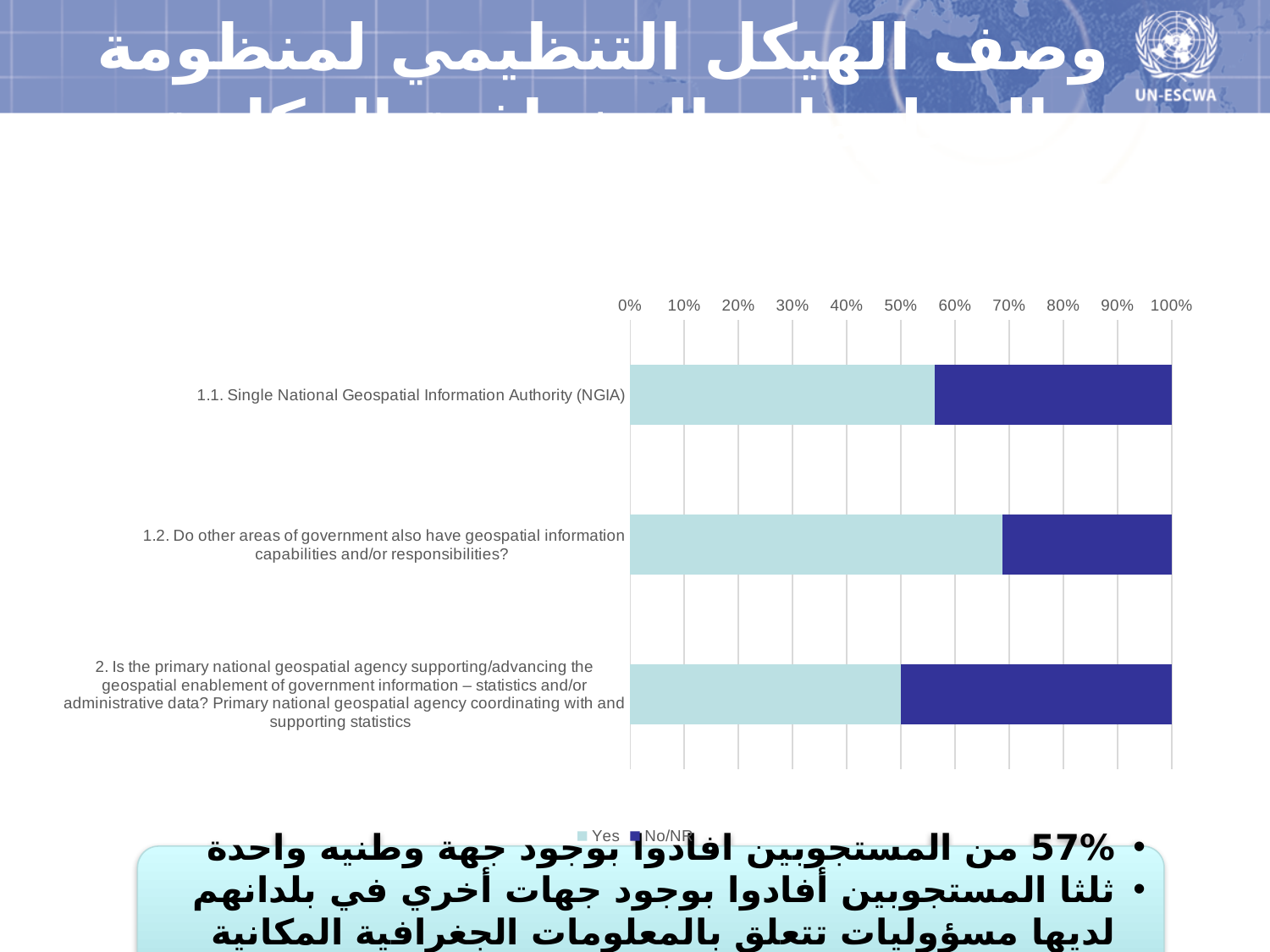
How many categories (questions) are plotted on the chart? 3 Is the "Yes" value for "1.1. Single National Geospatial Information Authority (NGIA)" greater or less than 70%? less What is the total of each stacked bar on the chart? 100% Which category has the largest "Yes" share? 1.2. Do other areas of government also have geospatial information capabilities and/or responsibilities? How many series does the chart legend list? 2 Which has a larger "Yes" share: category 1.1 (Single National Geospatial Information Authority) or category 1.2 (other areas of government with geospatial capabilities)? 1.2 Is the "Yes" value for "1.2. Do other areas of government also have geospatial information capabilities and/or responsibilities?" greater or less than 60%? greater What are the two series named in the legend? Yes and No/NR What kind of chart is shown on the slide? bar chart Is the "Yes" value for "1.1. Single National Geospatial Information Authority (NGIA)" greater or less than 50%? greater Which colour represents the "Yes" series? light blue